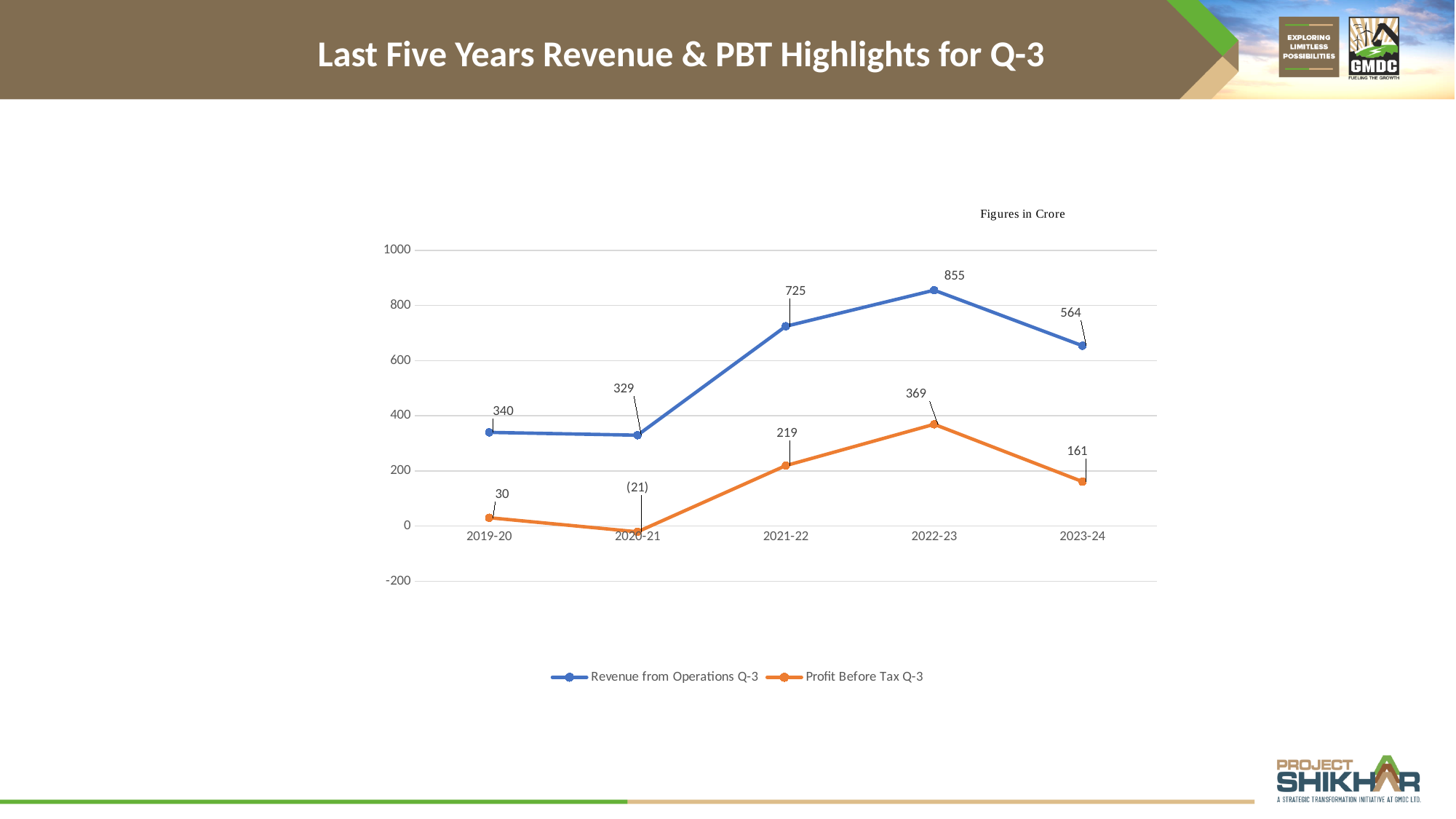
In which year is Profit Before Tax Q-3 lowest? 2020-21 What is the difference between Revenue from Operations Q-3 in 2022-23 and 2021-22? 130 What is the Profit Before Tax Q-3 value for 2020-21? (21) In which year is Revenue from Operations Q-3 highest? 2022-23 What type of chart is shown on the slide? line chart Does Revenue from Operations Q-3 rise or fall from 2022-23 to 2023-24? fall How many series does the legend list? 2 Which is larger: Profit Before Tax Q-3 in 2021-22 or in 2023-24? 2021-22 What unit note is printed above the chart? Figures in Crore What is the Revenue from Operations Q-3 value for 2021-22? 725 What is the Profit Before Tax Q-3 value for 2023-24? 161 How many years are plotted on the x axis? 5